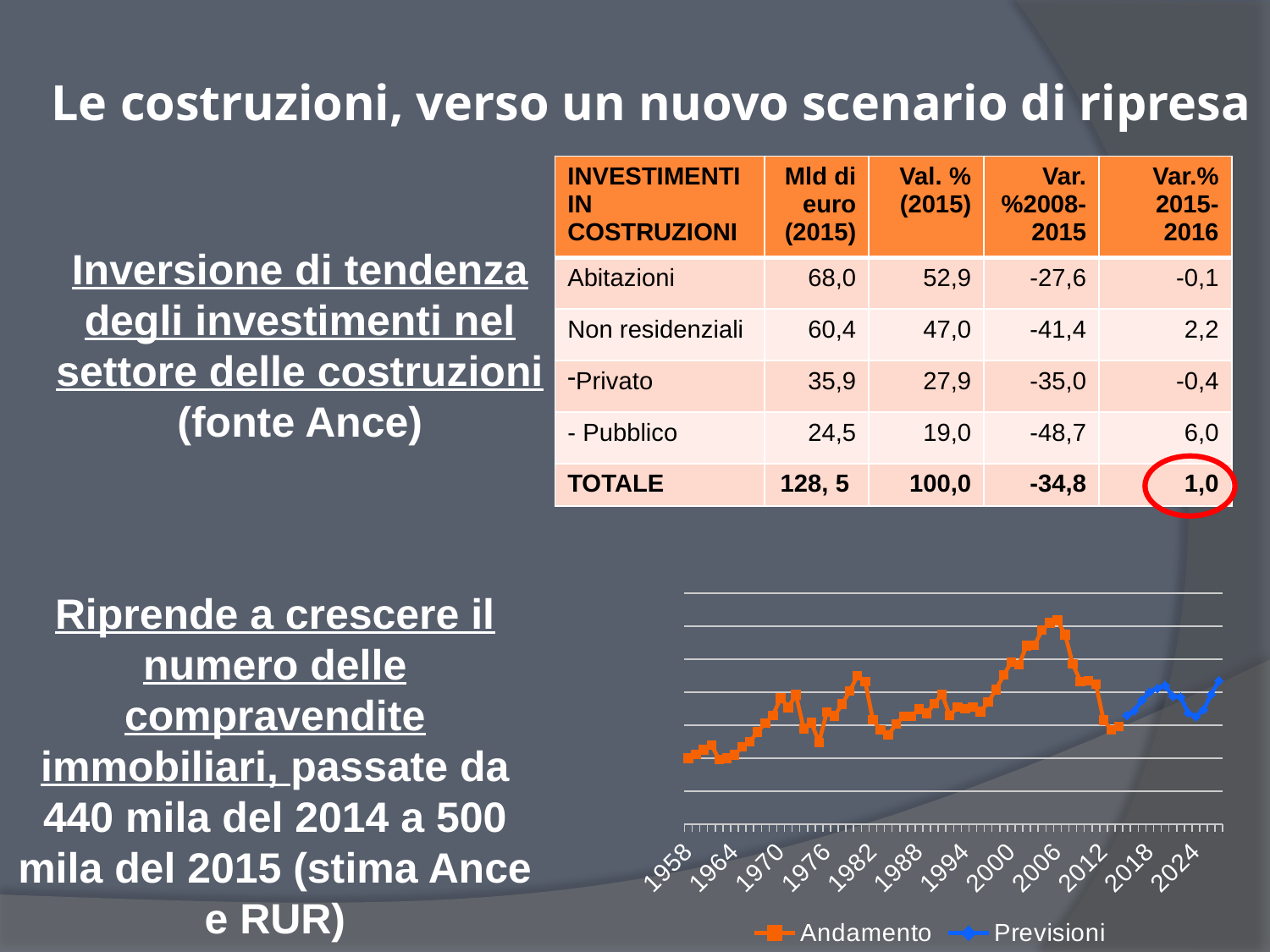
What is the first year label on the x axis of the line chart? 1958 How many series does the legend of the line chart list? 2 In the line chart, does the Andamento series rise or fall between 2006 and 2012? Fall What are the two series named in the legend of the line chart? Andamento and Previsioni What is the last year label on the x axis of the line chart? 2024 What kind of chart is shown at the bottom right of the slide? Line chart In the line chart, which colour is used for the Previsioni series? Blue In the line chart, is the Andamento series higher around 2006 or around 1982? Around 2006 In the line chart, does the Andamento series end (around 2015) higher or lower than it starts (around 1958)? Higher In the line chart, does the Previsioni series overall rise or fall from its start to its end? Rise How many year labels are shown on the x axis of the line chart? 12